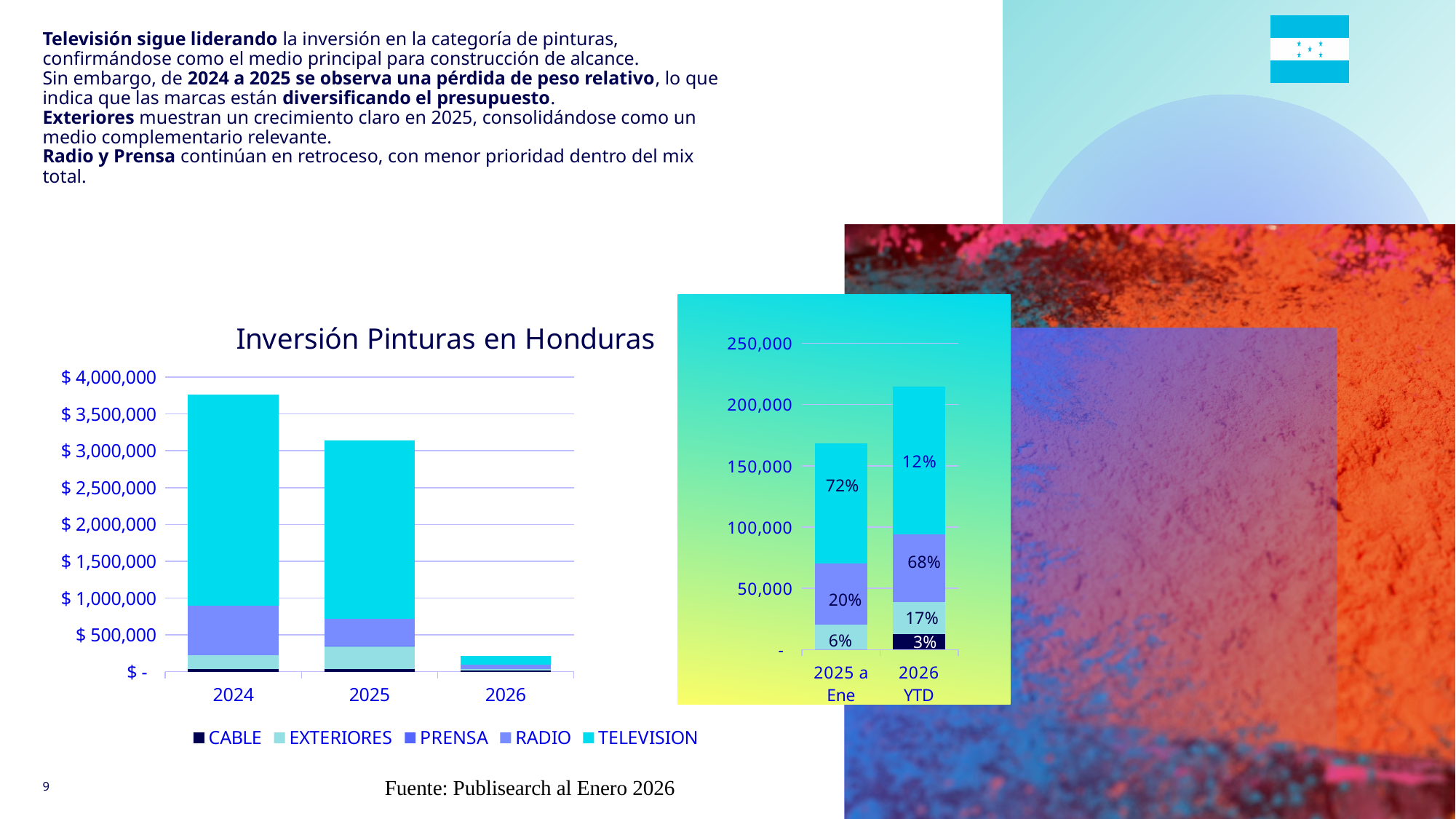
In the 'Inversión Pinturas en Honduras' chart, is the total for 2024 greater or less than $ 3,500,000? greater In the right-hand chart, is the total for '2026 YTD' greater or less than 200,000? greater In the 'Inversión Pinturas en Honduras' chart, how many years are shown on the x axis? 3 In the 'Inversión Pinturas en Honduras' chart, which series is shown in the darkest colour at the bottom of each bar? CABLE In the 'Inversión Pinturas en Honduras' chart, which year has the shortest stacked bar? 2026 In the 'Inversión Pinturas en Honduras' chart, is the total for 2025 greater or less than $ 3,500,000? less In the right-hand chart, what percentage label appears at the bottom of the '2026 YTD' bar? 3% What kind of chart is 'Inversión Pinturas en Honduras'? bar chart In the 'Inversión Pinturas en Honduras' chart, do the total bar heights rise or fall from 2024 to 2026? fall In the 'Inversión Pinturas en Honduras' chart, which year has the tallest stacked bar? 2024 In the right-hand chart, what is the largest percentage label shown in the '2025 a Ene' bar? 72% In the 'Inversión Pinturas en Honduras' chart, how many series does the legend list? 5